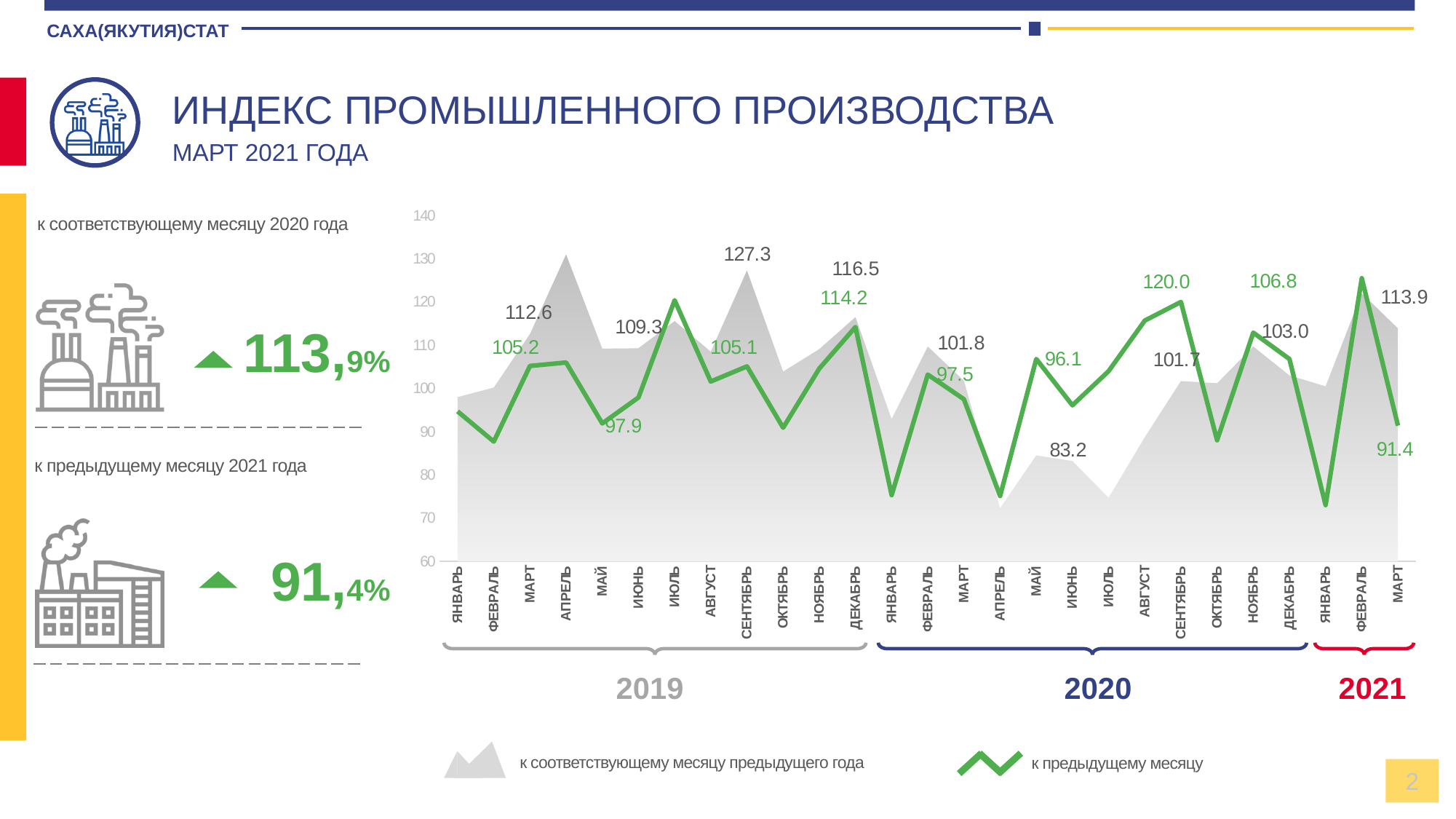
How many series does the legend list? 2 What is the value of the green line (к предыдущему месяцу) for March 2021? 91.4 What is the value of the grey area series (к соответствующему месяцу предыдущего года) for March 2021? 113.9 What value is labelled on the green line at September 2020? 120.0 Which is larger on the green line: the value for September 2020 or the value for March 2021? September 2020 What value is labelled on the green line at December 2019? 114.2 Is the green line value for February 2021 greater or less than 120? greater What value is labelled on the grey area series at September 2019? 127.3 How many months are plotted along the x axis? 27 Is the green line value for January 2020 greater or less than 80? less What is the difference between the grey area value and the green line value for March 2021? 22.5 Does the green line rise or fall from February 2021 to March 2021? fall